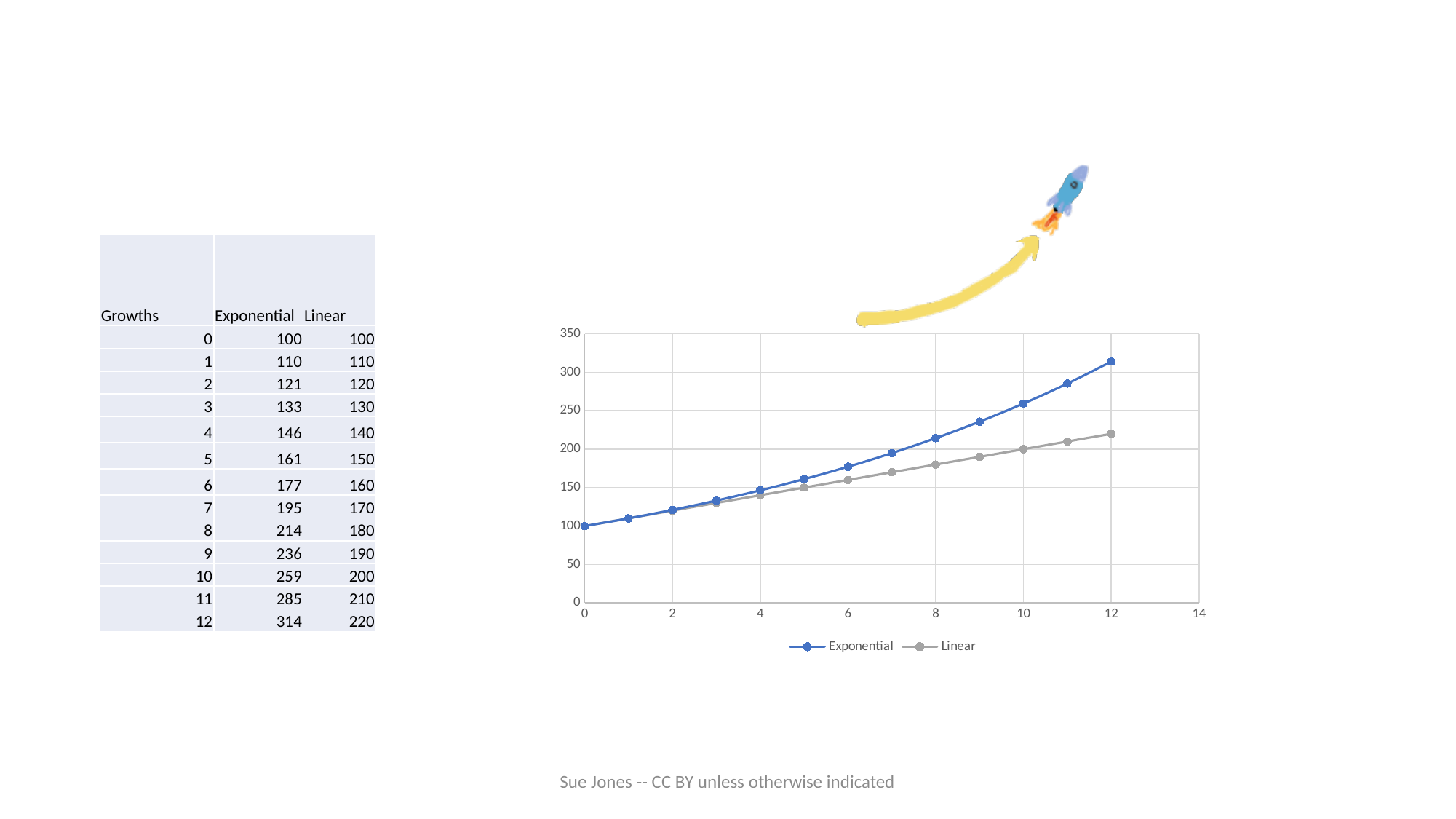
What is the Linear value at growth 12? 220 Is the Exponential value at growth 12 greater or less than 300? greater What is the Exponential value at growth 8? 214 How many series does the chart's legend list? 2 What is the difference between the Exponential and Linear values at growth 12? 94 What kind of chart is shown on the slide? line chart What are the two series named in the chart's legend? Exponential and Linear Do the Exponential values rise or fall as growth increases from 0 to 12? rise At growth 10, which series has the larger value, Exponential or Linear? Exponential What is the Exponential value at growth 12? 314 How many data points are plotted for the Exponential series? 13 Which series is drawn in blue on the chart? Exponential